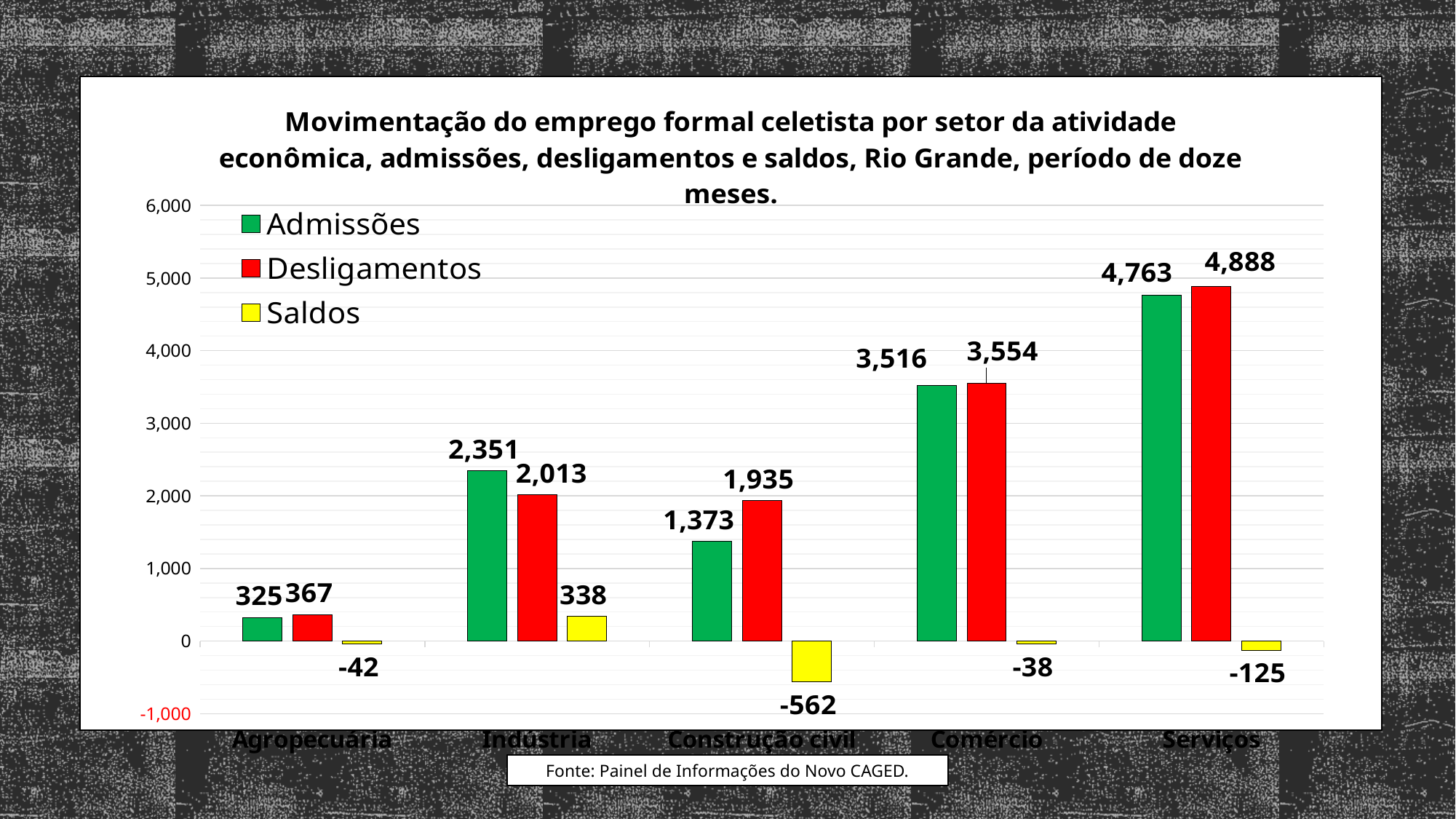
Is the Admissões value for Comércio greater or less than 3,000? greater Which colour represents the Saldos series? Yellow Which sector has the lowest Desligamentos value? Agropecuária What is the Admissões value for Indústria? 2,351 How many sectors are shown on the x axis? 5 What is the Desligamentos value for Serviços? 4,888 Which sector has the highest Admissões value? Serviços How many series does the legend list? 3 What is the Saldos value for Construção civil? -562 What is the difference between Desligamentos and Admissões for Construção civil? 562 Which is larger for Indústria, Admissões or Desligamentos? Admissões What kind of chart is shown on the slide? Bar chart